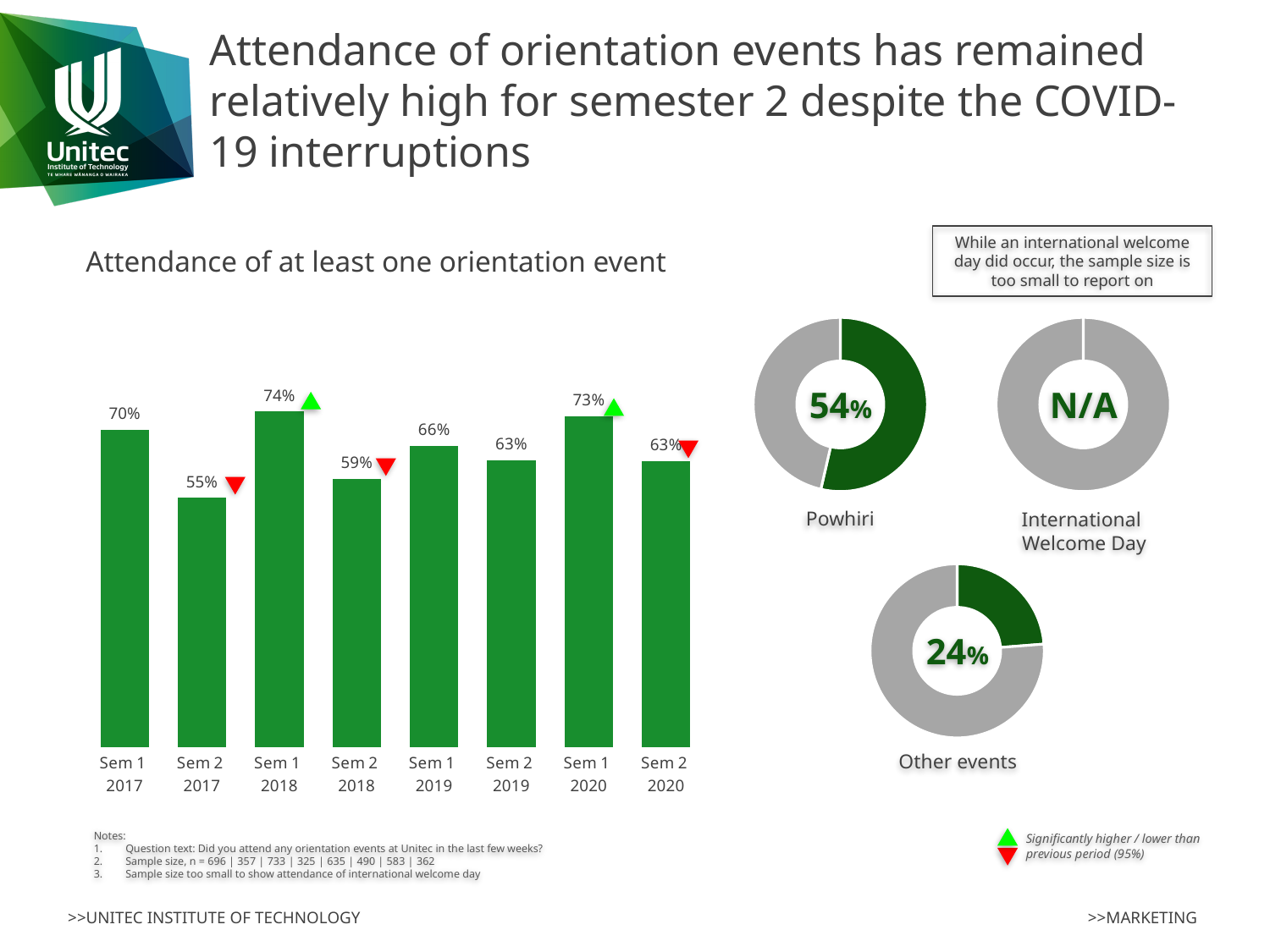
In the 'Attendance of at least one orientation event' bar chart, which semester has the highest attendance? Sem 1 2018 How many bars are in the 'Attendance of at least one orientation event' bar chart? 8 In the 'Attendance of at least one orientation event' bar chart, what is the value for Sem 2 2018? 59% In the 'Attendance of at least one orientation event' bar chart, which is larger, Sem 1 2020 or Sem 1 2019? Sem 1 2020 In the 'Attendance of at least one orientation event' bar chart, which semester has the lowest attendance? Sem 2 2017 What value is shown in the 'International Welcome Day' donut chart? N/A In the 'Attendance of at least one orientation event' bar chart, what is the difference between Sem 1 2018 and Sem 2 2017? 19% In the 'Other events' donut chart on the right, what percentage is shown? 24% In the 'Attendance of at least one orientation event' bar chart, what is the value for Sem 1 2017? 70% What kind of chart is 'Attendance of at least one orientation event'? Bar chart In the 'Attendance of at least one orientation event' bar chart, what is the value for Sem 2 2020? 63% In the Powhiri donut chart on the right, what percentage is shown? 54%